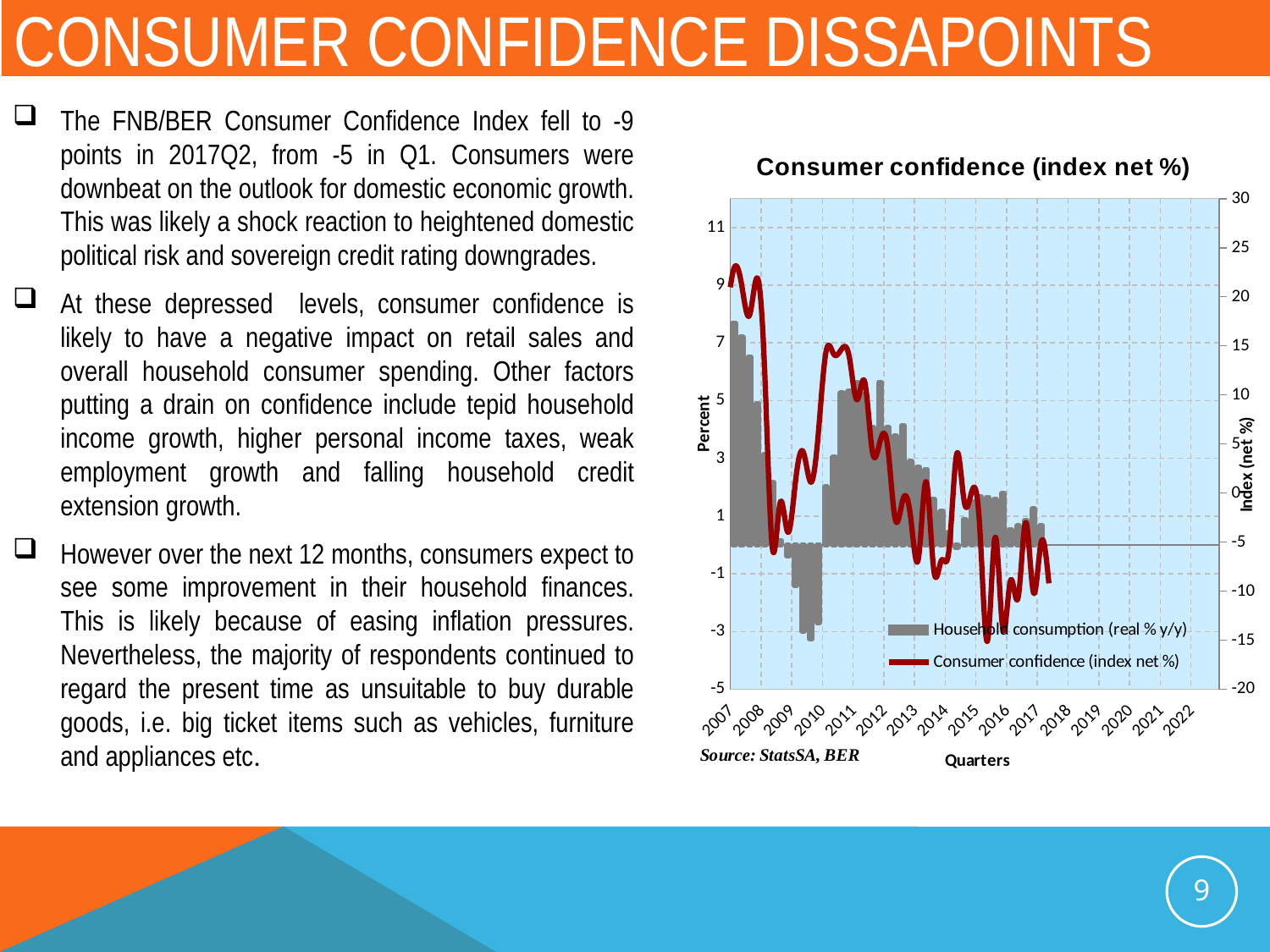
Is the consumer confidence index in 2016 greater or less than 0 on the right-hand axis? less Which series is plotted as a line in the chart? Consumer confidence (index net %) How many series does the chart's legend list? 2 What is the title of the chart? Consumer confidence (index net %) Is the consumer confidence index in 2007 greater or less than 10 on the right-hand axis? greater What is the highest value shown on the right-hand axis of the chart? 30 How many year labels are shown on the x axis of the chart? 16 Does the consumer confidence line generally rise or fall between 2007 and 2017? fall What is the lowest value shown on the left-hand axis of the chart? -5 Is the household consumption value in 2009 greater or less than 0 percent? less What kind of chart is shown on the slide? A combined bar and line chart